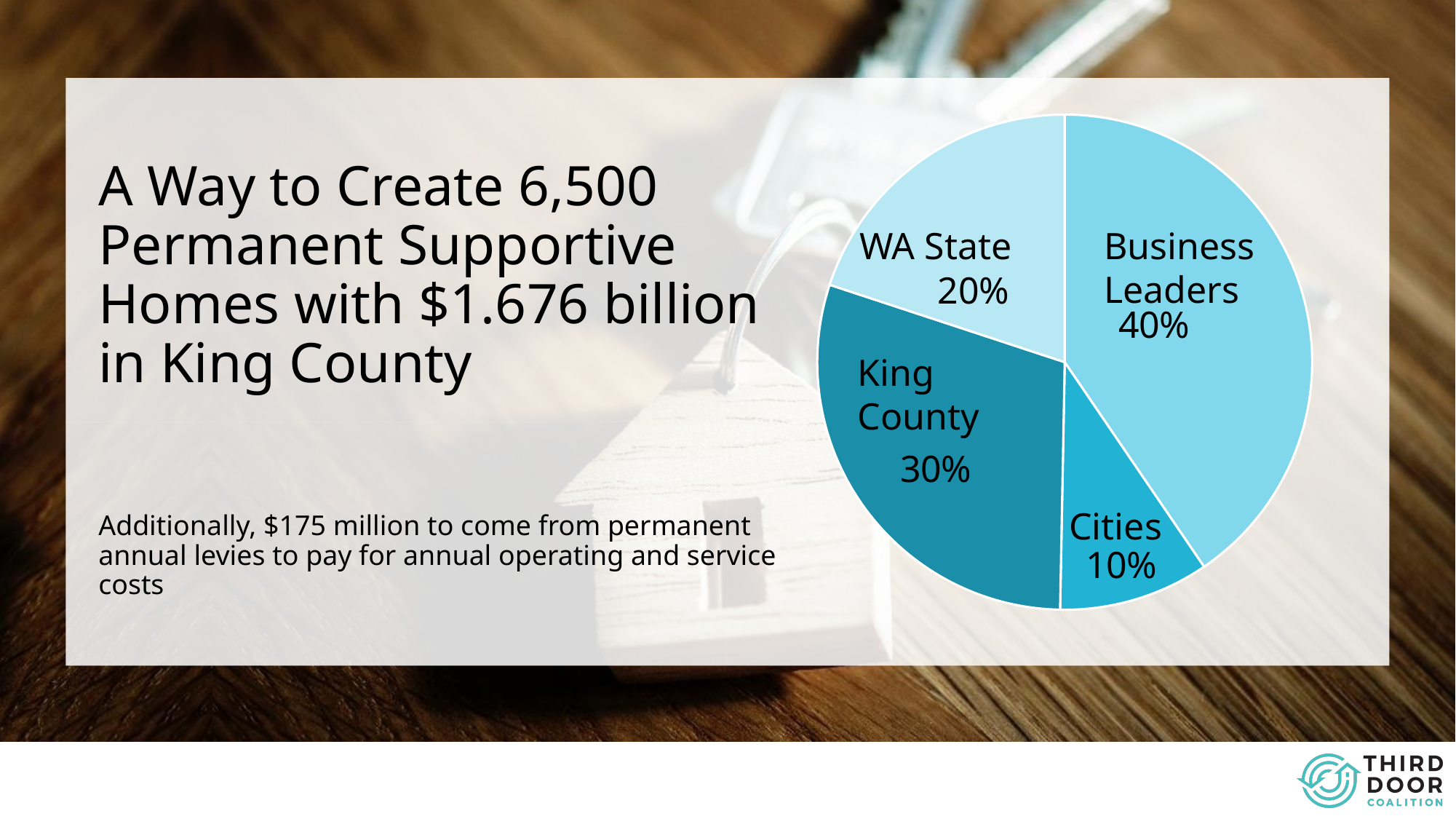
What kind of chart is shown on the slide? pie chart What is the combined share of the King County and WA State slices? 50% Which slice of the pie is the largest? Business Leaders Which slice of the pie is the smallest? Cities What share of the pie does Cities account for? 10% Which is larger, the WA State slice or the Cities slice? WA State What share of the pie does King County account for? 30% What is the title of the slide containing the pie chart? A Way to Create 6,500 Permanent Supportive Homes with $1.676 billion in King County What share of the pie does Business Leaders account for? 40% How many slices does the pie chart have? 4 What share of the pie does WA State account for? 20% What is the difference in percentage points between the Business Leaders slice and the King County slice? 10